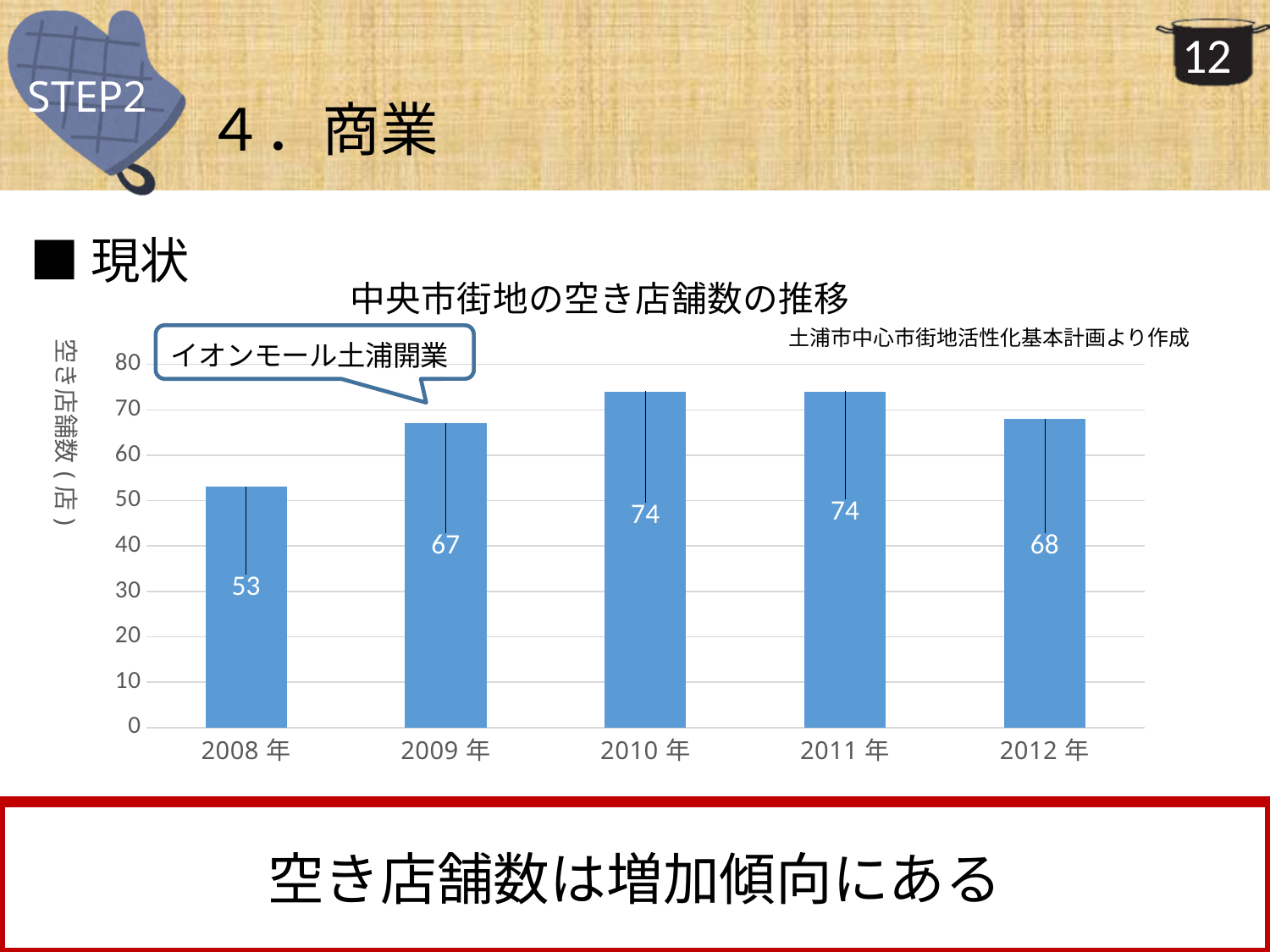
What kind of chart is shown on the slide? bar chart How many years are shown on the x axis? 5 Which year has the lowest number of vacant stores? 2008年 Which is larger, the value for 2009年 or the value for 2012年? 2012年 What is the number of vacant stores in 2012年? 68 What is the title of the chart? 中央市街地の空き店舗数の推移 Do the values generally rise or fall from 2008年 to 2011年? rise What is the difference between the values for 2010年 and 2008年? 21 What is the value shown for 2009年? 67 Is the value for 2008年 greater or less than 60? less What is the difference between the values for 2011年 and 2012年? 6 What is the number of vacant stores in 2008年? 53